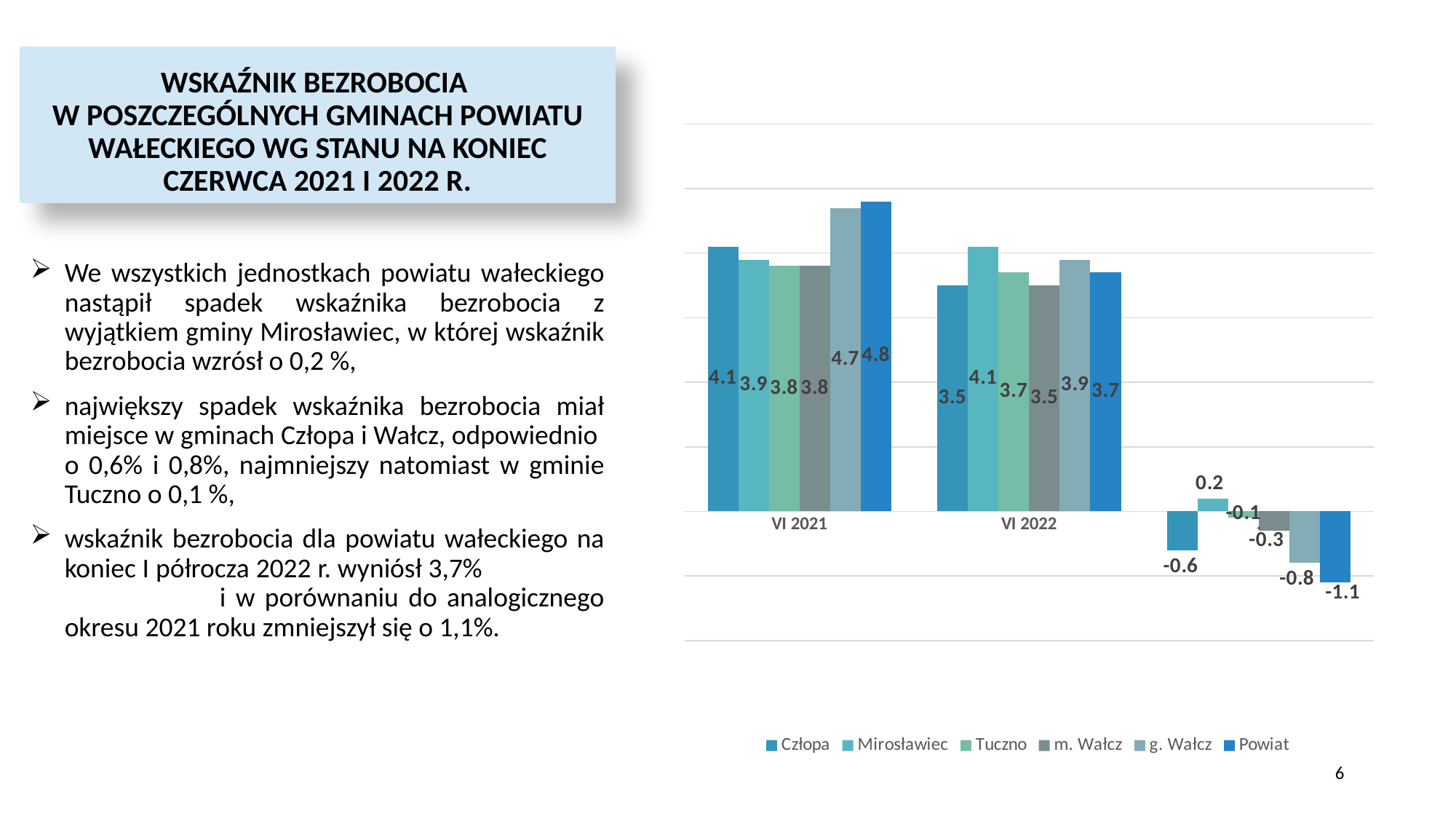
Which series has the highest value in the VI 2021 group? Powiat What is the value for Powiat in VI 2021? 4.8 Which series has the highest value in the VI 2022 group? Mirosławiec What is the first entry in the chart legend? Człopa What is the value for Tuczno in VI 2021? 3.8 What is the difference between the Powiat value in VI 2021 and in VI 2022? 1.1 Is the value for g. Wałcz larger in VI 2021 or in VI 2022? VI 2021 What kind of chart is shown on the slide? bar chart What is the value for Człopa in VI 2022? 3.5 How many series does the legend list? 6 What is the value for Mirosławiec in VI 2022? 4.1 What is the difference between the g. Wałcz value in VI 2021 and in VI 2022? 0.8